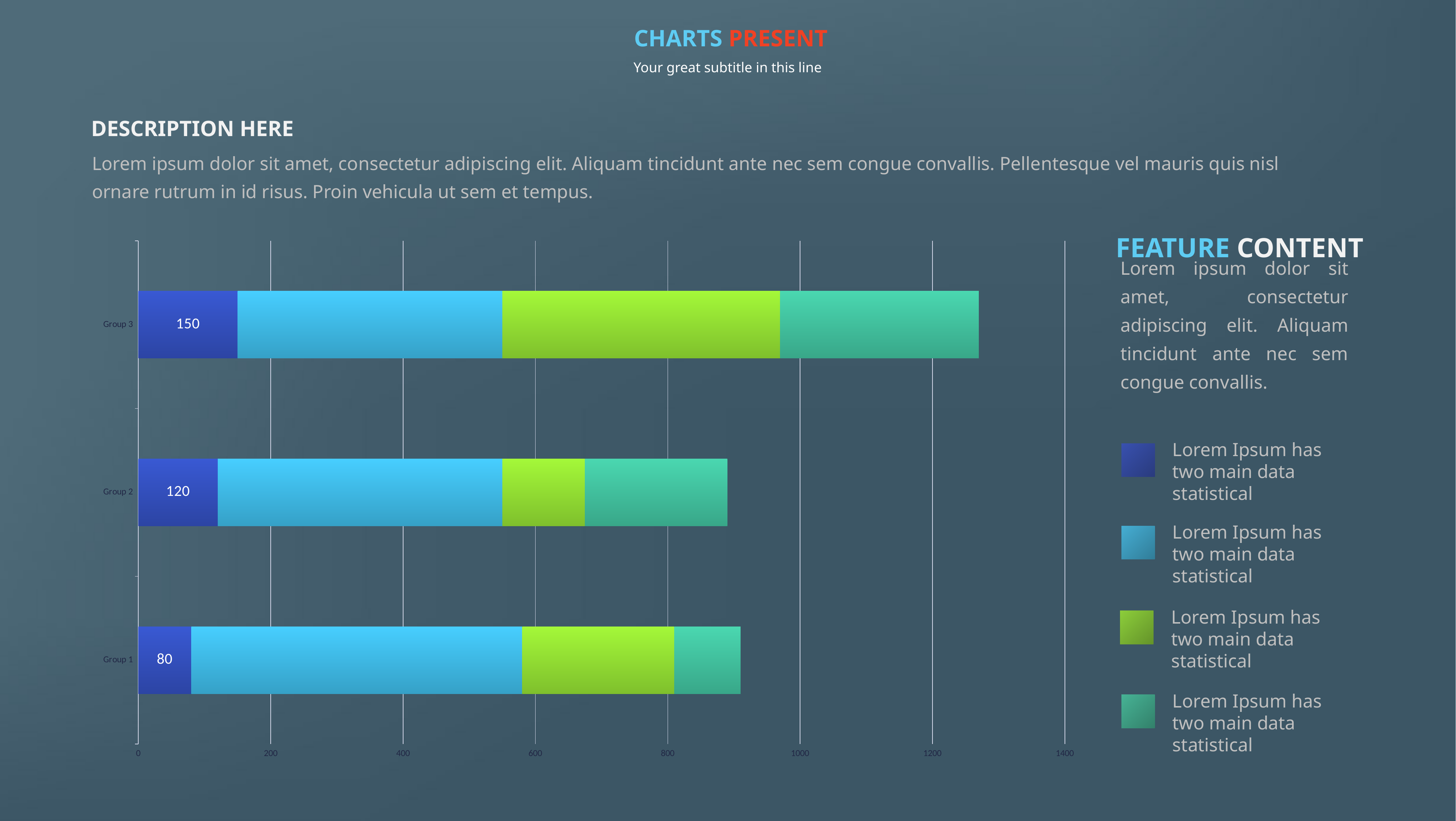
What is the labelled value of the first (dark blue) segment for Group 1? 80 Which group has the highest labelled value in the first (dark blue) segment? Group 3 What type of chart is shown on the slide? Stacked bar chart What is the labelled value of the first (dark blue) segment for Group 3? 150 Is the total length of the Group 3 bar greater or less than 1200? greater How many series does the legend list? 4 Which group has the lowest labelled value in the first (dark blue) segment? Group 1 What is the labelled value of the first (dark blue) segment for Group 2? 120 Which is larger, the dark blue segment value for Group 2 or for Group 1? Group 2 What is the difference between the dark blue segment values of Group 3 and Group 1? 70 Is the total length of the Group 1 bar greater or less than 1000? less How many groups (categories) are plotted on the chart? 3